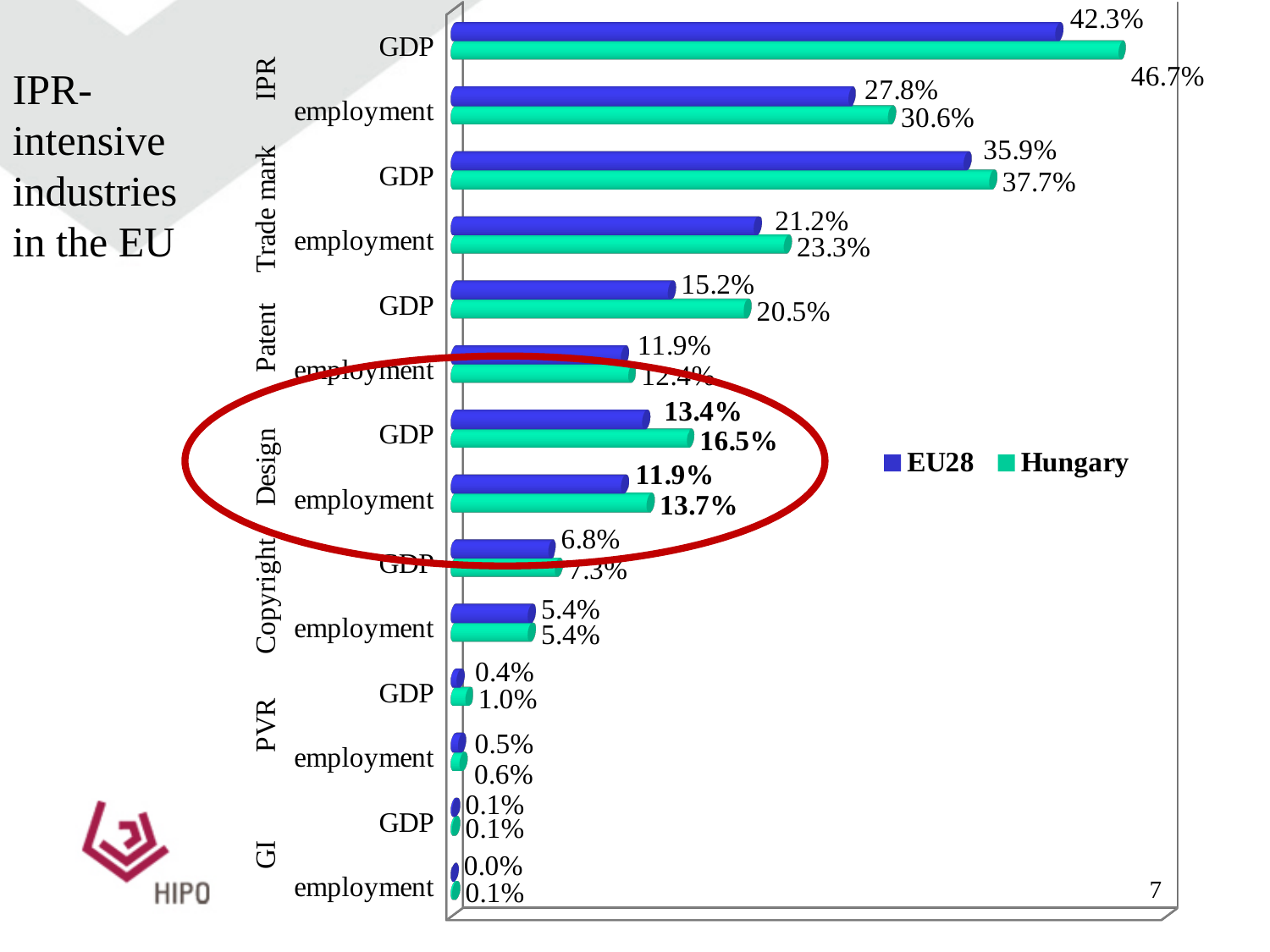
Which series is shown in green in the legend? Hungary What is the Hungary value for IPR GDP? 46.7% What is the difference between the Hungary and EU28 values for Patent GDP? 5.3% Which is larger for Design employment, the EU28 value or the Hungary value? Hungary What kind of chart is shown on the slide? bar chart What is the Hungary value for Design GDP? 16.5% How many series does the legend list? 2 What is the EU28 value for Trade mark employment? 21.2% Which category has the lowest EU28 value? GI employment How many category bars (GDP/employment rows) are plotted on the chart? 14 Which category has the highest EU28 value? IPR GDP What is the EU28 value for Patent GDP? 15.2%